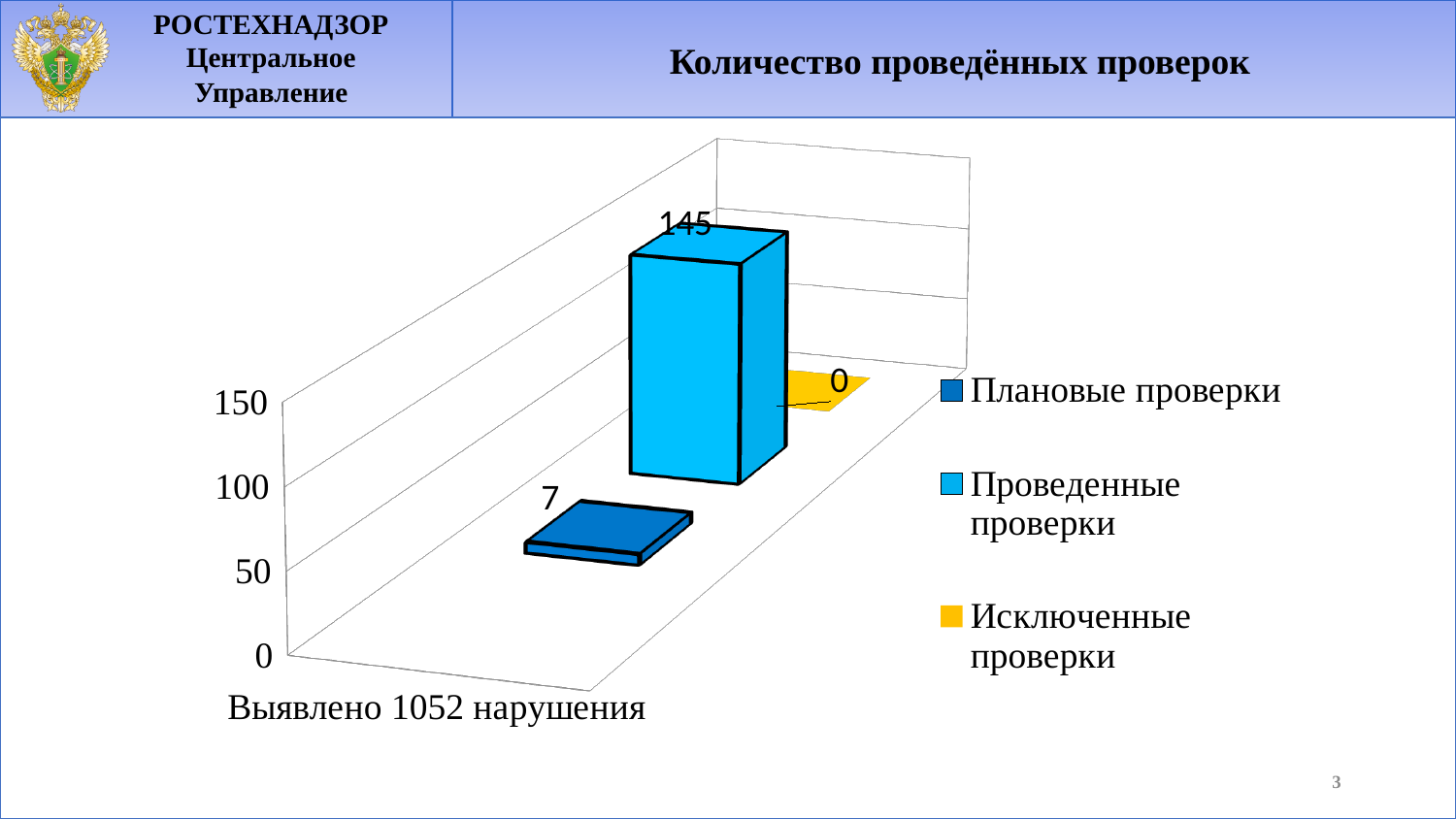
Is the value for Проведенные проверки greater or less than 100? greater What is the value for Проведенные проверки? 145 Which series has the lowest value? Исключенные проверки Which is larger, Плановые проверки or Проведенные проверки? Проведенные проверки What is the value for Исключенные проверки? 0 What is the title of the chart? Количество проведённых проверок Which series has the highest value? Проведенные проверки What kind of chart is shown on the slide? bar chart What colour is the bar for Исключенные проверки? yellow What is the difference between Проведенные проверки and Плановые проверки? 138 How many series does the legend list? 3 What is the value for Плановые проверки? 7